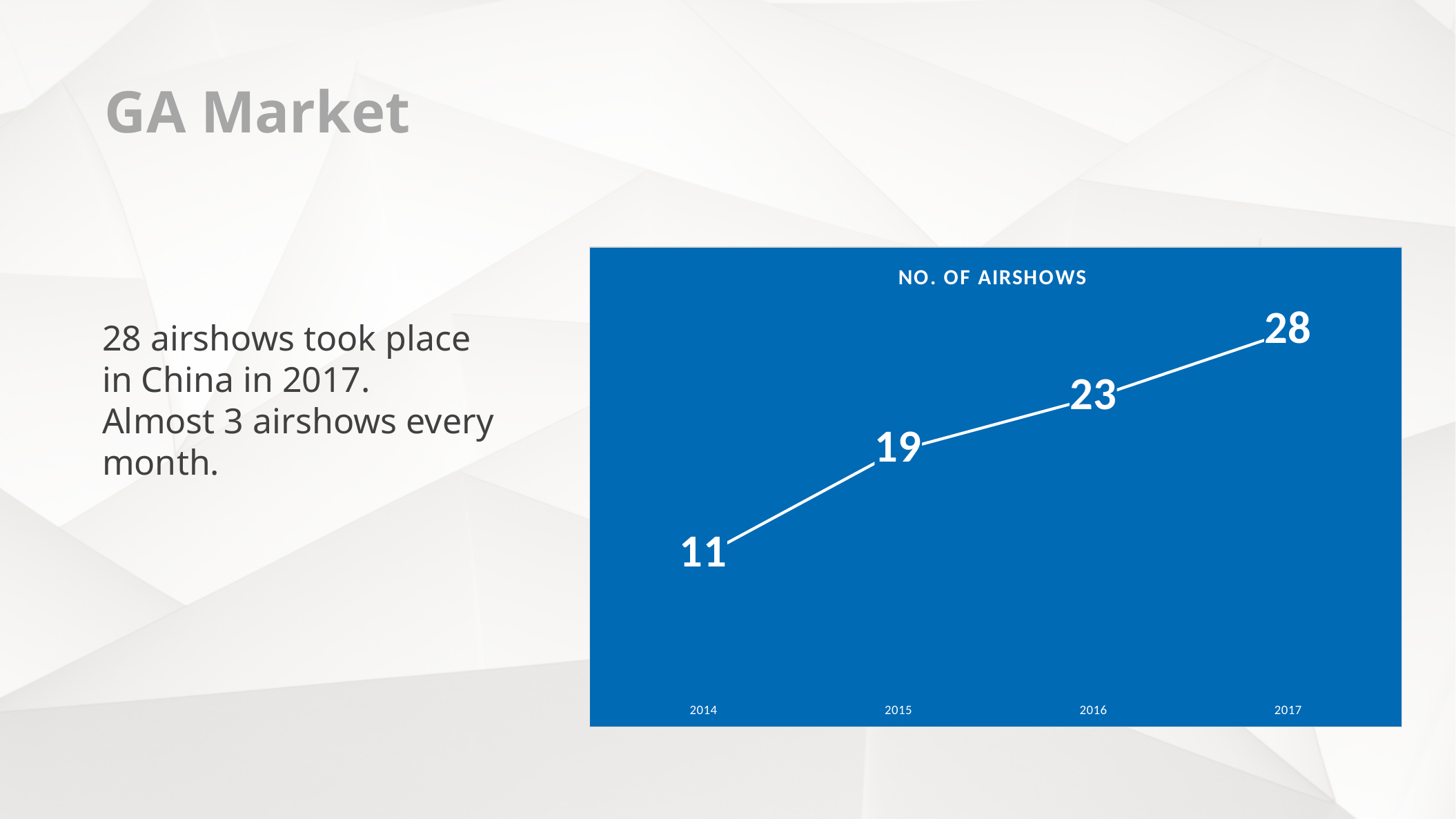
Which year has more airshows, 2015 or 2016? 2016 What kind of chart is shown on the slide? Line chart What is the number of airshows in 2017? 28 What is the number of airshows in 2015? 19 How many years are plotted on the chart? 4 What is the number of airshows in 2016? 23 What is the difference in the number of airshows between 2017 and 2014? 17 Which year has the lowest number of airshows? 2014 What is the number of airshows in 2014? 11 What is the difference in the number of airshows between 2015 and 2014? 8 Does the number of airshows rise or fall from 2014 to 2017? Rise Which year has the highest number of airshows? 2017